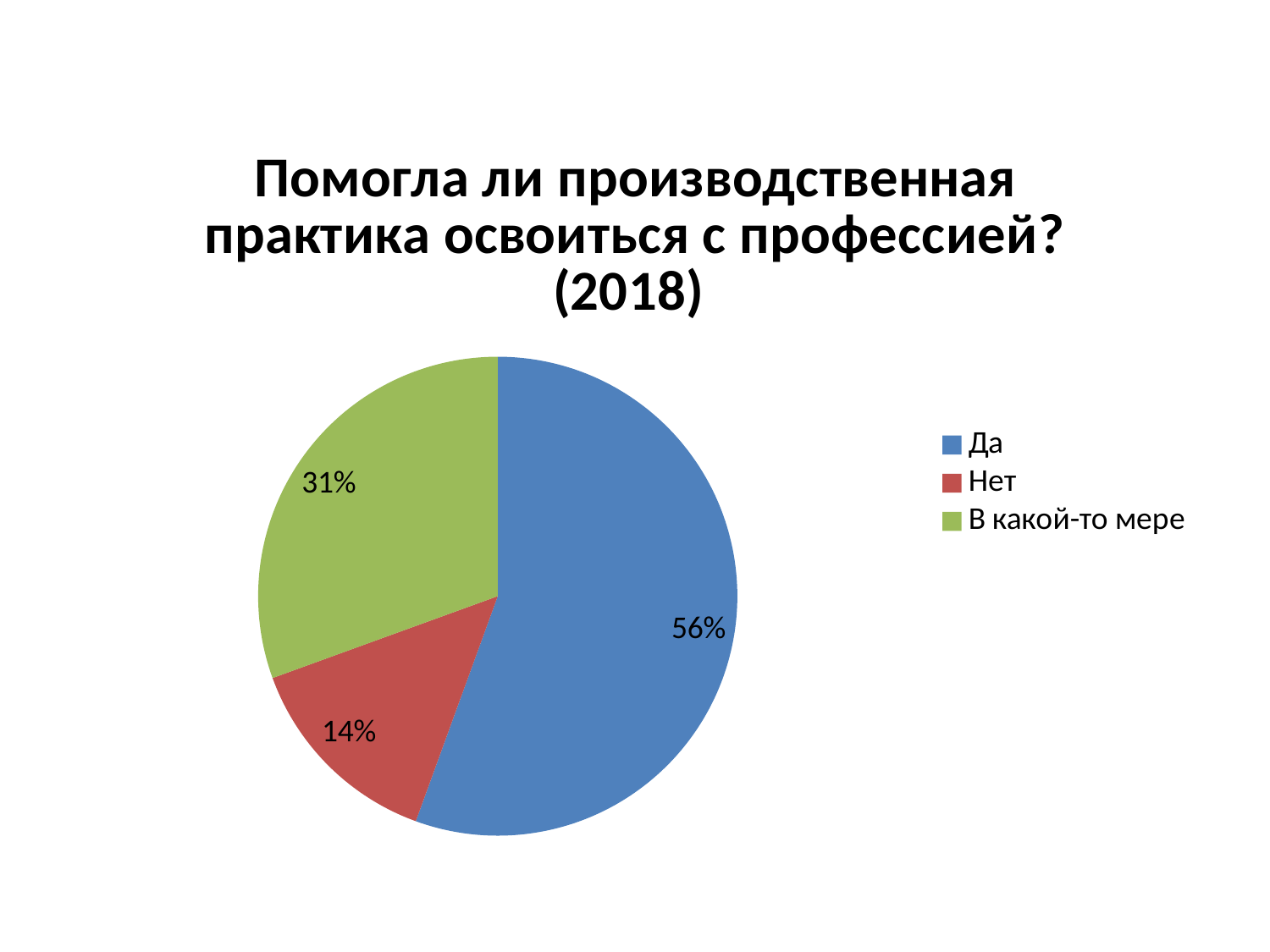
How many categories does the pie chart have? 3 What is the difference in percentage points between "Да" and "Нет"? 42 Which is larger, the slice for "В какой-то мере" or the slice for "Нет"? В какой-то мере What is the difference in percentage points between "В какой-то мере" and "Нет"? 17 What colour is the slice for "Нет"? red What share of the pie does "В какой-то мере" take? 31% What kind of chart is shown on the slide? pie chart What is the title of the chart? Помогла ли производственная практика освоиться с профессией? (2018) Which category has the smallest slice of the pie? Нет What share of the pie does "Да" take? 56% Which category has the largest slice of the pie? Да What share of the pie does "Нет" take? 14%